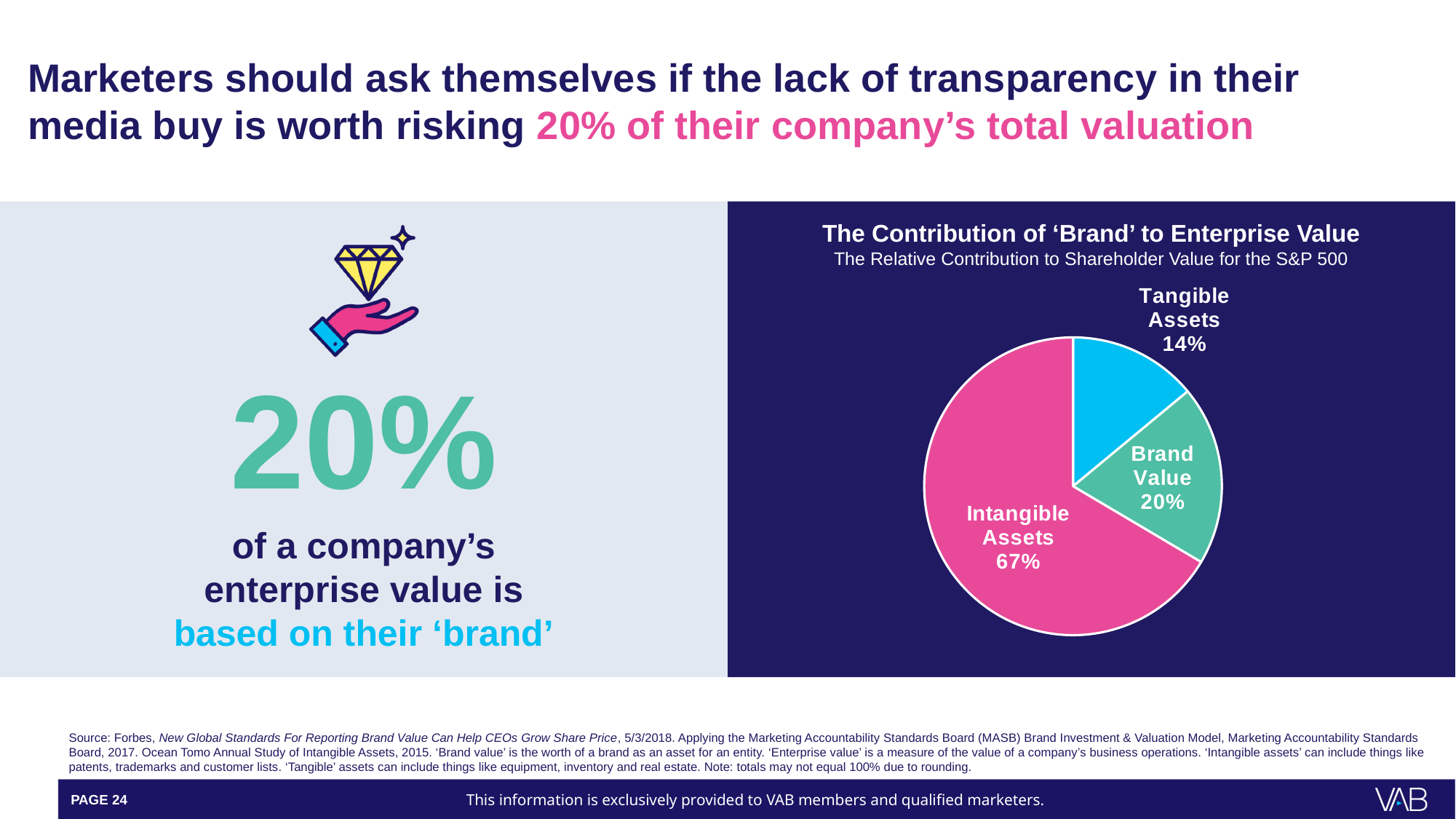
Which is larger in the pie chart, Brand Value or Tangible Assets? Brand Value What kind of chart is shown on the slide? Pie chart What is the difference between the Brand Value and Tangible Assets slices? 6 percentage points What is the value for Brand Value in the pie chart? 20% What colour is the Intangible Assets slice in the pie chart? Pink Which slice of the pie chart is the largest? Intangible Assets What is the value for Intangible Assets in the pie chart? 67% What is the difference between the Intangible Assets and Brand Value slices? 47 percentage points What is the value for Tangible Assets in the pie chart? 14% Which slice of the pie chart is the smallest? Tangible Assets How many slices does the pie chart have? 3 What is the title of the pie chart? The Contribution of 'Brand' to Enterprise Value